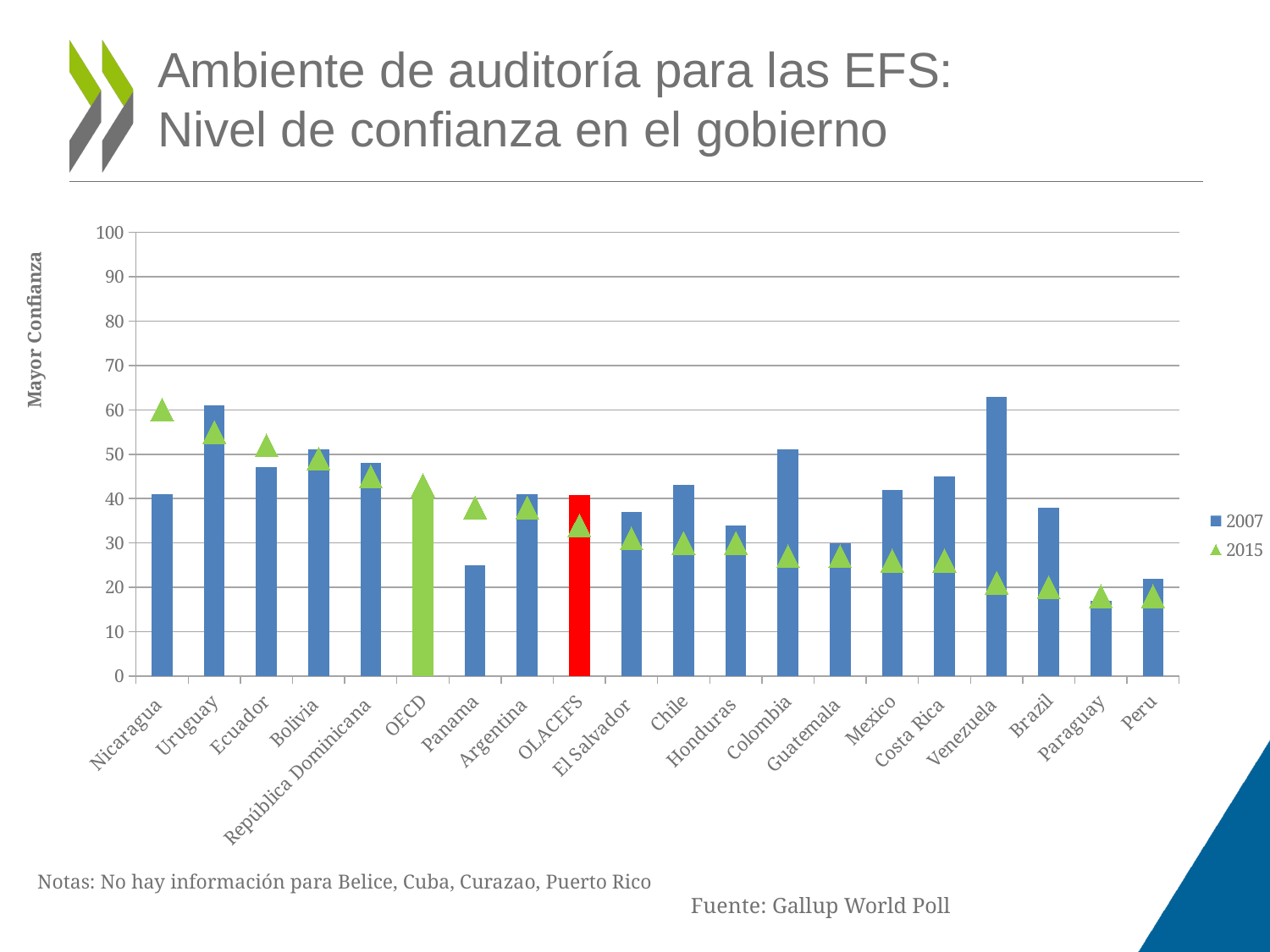
Is the 2007 value for Panama greater or less than 30? less Is the 2015 value for Nicaragua greater or less than 50? greater Which has the larger 2007 value, Uruguay or Nicaragua? Uruguay Which category has the highest 2015 marker? Nicaragua Is the 2007 value for Paraguay greater or less than 20? less How many countries or groups are shown along the x axis? 20 How many series does the legend list? 2 Which category's bar is coloured red? OLACEFS What kind of chart is shown on the slide? bar chart (with triangle markers for 2015) Which has the larger 2007 value, Colombia or Guatemala? Colombia Which category has the lowest 2007 bar? Paraguay